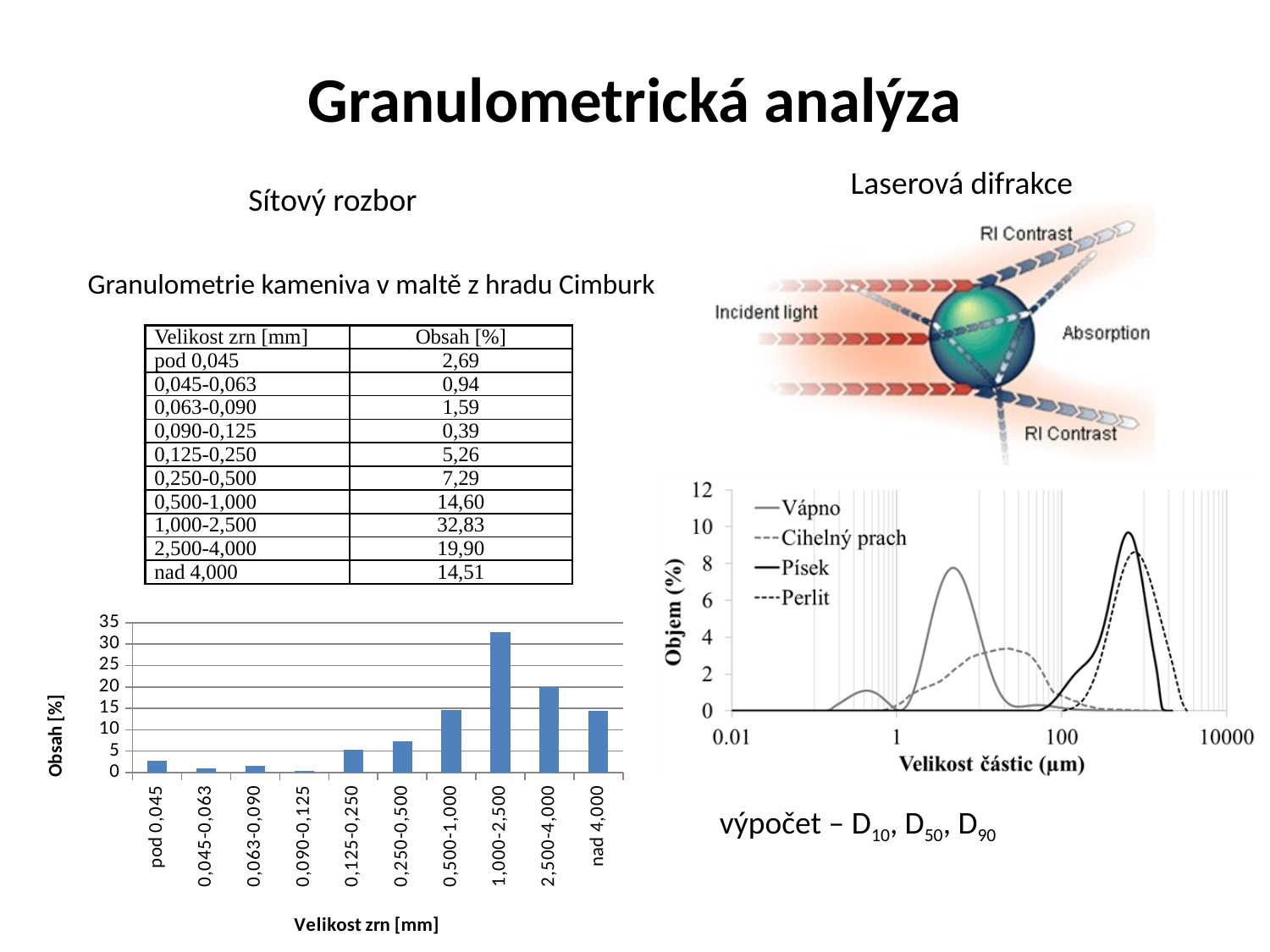
In the bottom-right line chart, is the peak value of the Vápno series greater or less than 6? greater In the bottom-left bar chart, which is larger: the value for 2,500-4,000 or the value for 0,250-0,500? 2,500-4,000 Using the table values, what is the difference in Obsah [%] between the 1,000-2,500 and 2,500-4,000 categories in the bottom-left bar chart? 12,93 According to the table above the bottom-left bar chart, what is the Obsah [%] for the 1,000-2,500 mm category? 32,83 In the bottom-right line chart, which series reaches the highest peak Objem (%)? Písek In the bottom-left bar chart, which grain-size category has the lowest Obsah [%]? 0,090-0,125 How many series does the legend of the bottom-right line chart list? 4 In the bottom-left bar chart, is the value for 0,500-1,000 greater or less than 10? greater What kind of chart is the bottom-left chart on the slide? bar chart In the bottom-left bar chart, which grain-size category has the highest Obsah [%]? 1,000-2,500 According to the table above the bottom-left bar chart, what is the Obsah [%] for the 2,500-4,000 mm category? 19,90 In the bottom-left bar chart, how many grain-size categories are shown on the x axis? 10